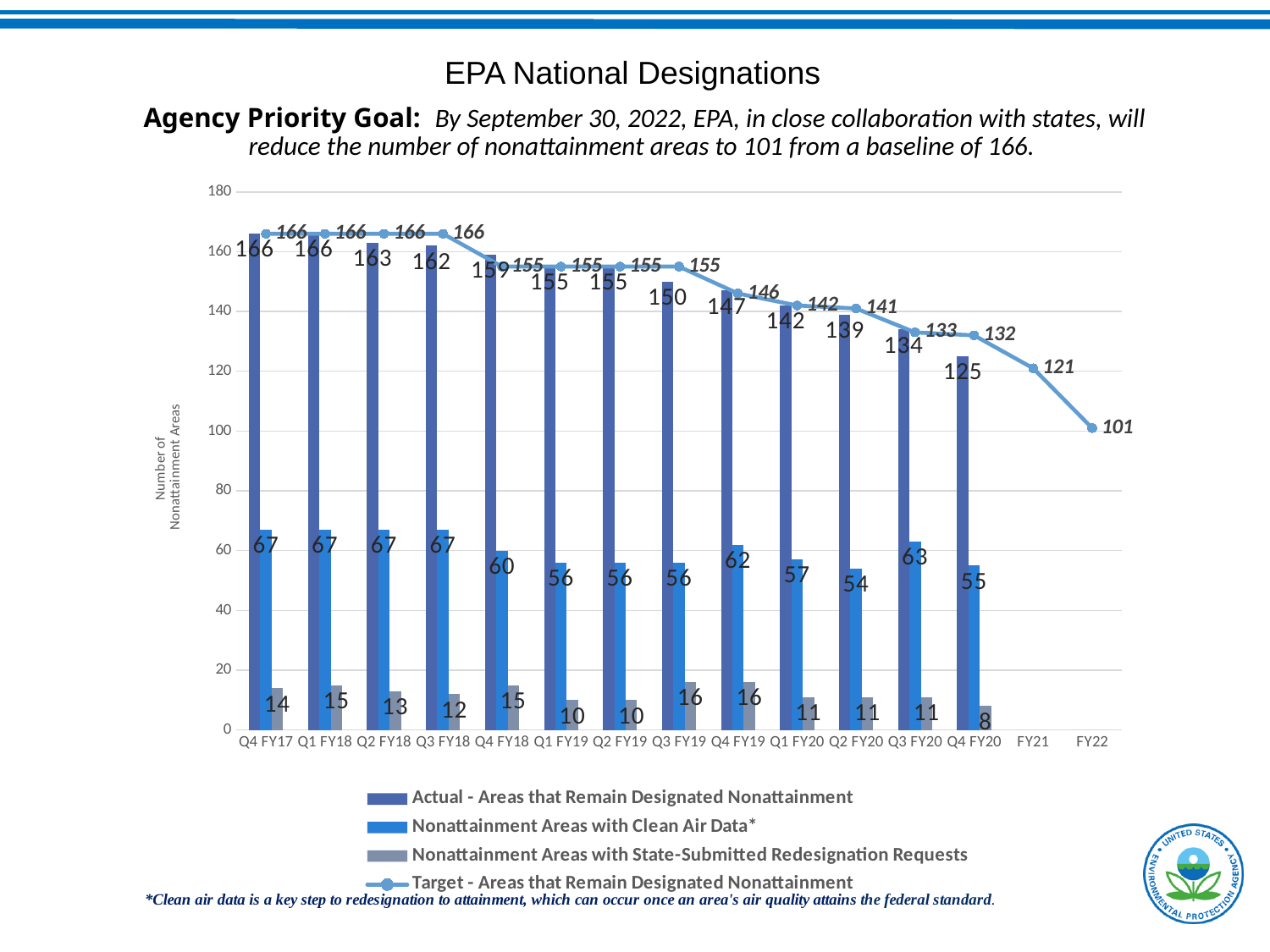
What is the Target - Areas that Remain Designated Nonattainment value for FY22? 101 Which period has the lowest value for Actual - Areas that Remain Designated Nonattainment? Q4 FY20 What is the Target value for FY21? 121 What is the value of Nonattainment Areas with Clean Air Data for Q4 FY18? 60 How many periods are shown on the x axis? 15 How many series does the legend list? 4 What is the difference between the Actual values for Q4 FY17 and Q4 FY20? 41 What is the value of Nonattainment Areas with State-Submitted Redesignation Requests for Q4 FY20? 8 Do the Actual - Areas that Remain Designated Nonattainment values rise or fall from Q4 FY17 to Q4 FY20? fall Which period has the lowest value for Nonattainment Areas with State-Submitted Redesignation Requests? Q4 FY20 Which is larger, the Nonattainment Areas with Clean Air Data value for Q4 FY19 or for Q1 FY20? Q4 FY19 What is the value of Actual - Areas that Remain Designated Nonattainment for Q4 FY20? 125